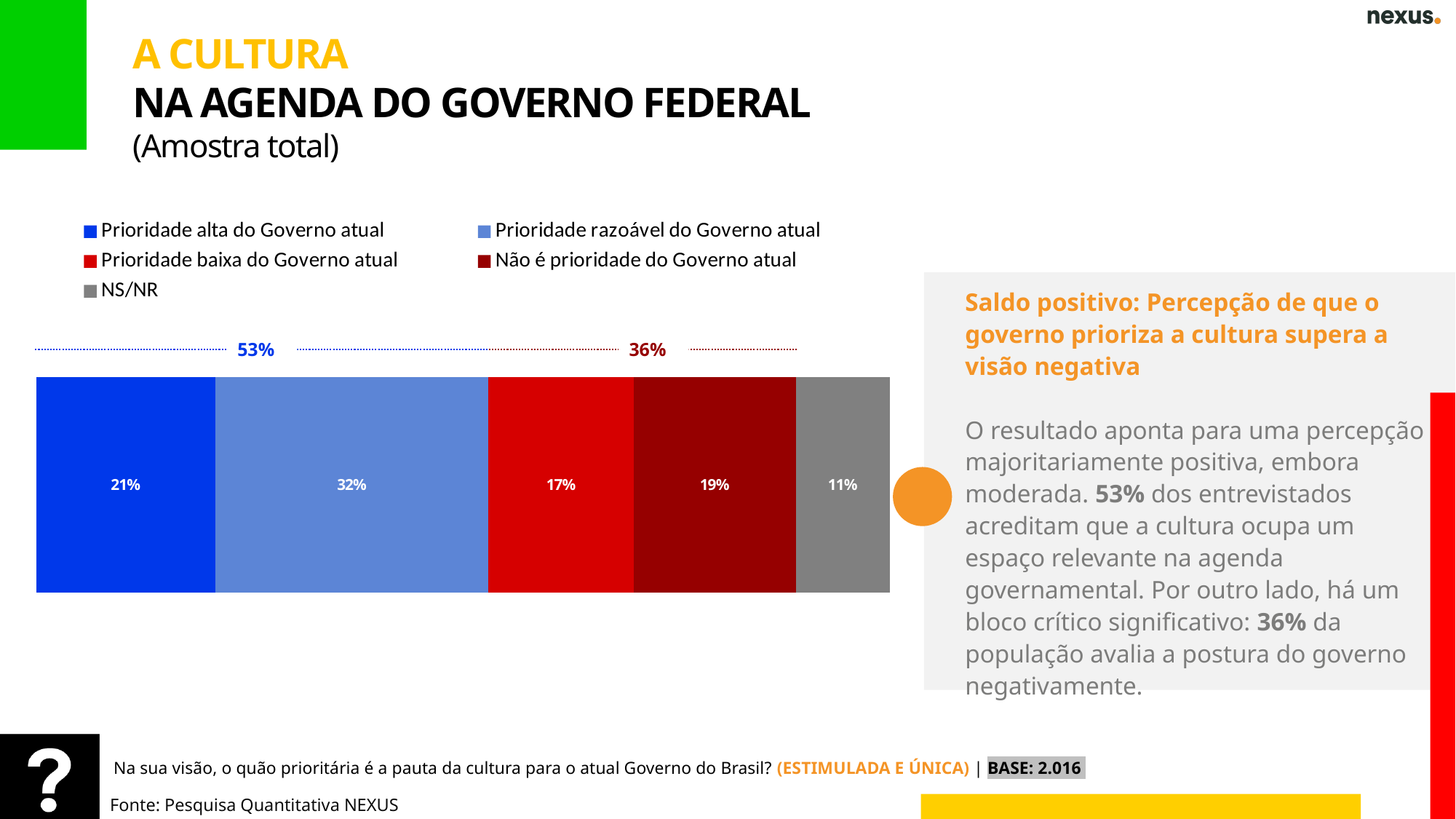
What is the value for 'Prioridade baixa do Governo atual'? 17% What is the value for NS/NR? 11% Which response category has the largest share in the bar? Prioridade razoável do Governo atual What is the value for 'Não é prioridade do Governo atual'? 19% What is the difference between 'Prioridade razoável do Governo atual' and 'Prioridade alta do Governo atual'? 11 percentage points Which is larger: 'Não é prioridade do Governo atual' or 'Prioridade baixa do Governo atual'? Não é prioridade do Governo atual What is the value for 'Prioridade razoável do Governo atual'? 32% Which response category has the smallest share in the bar? NS/NR How many series does the legend list? 5 What kind of chart is shown on the slide? Stacked bar chart What percentage of respondents said culture is a high priority of the current government (Prioridade alta do Governo atual)? 21% What combined percentage is shown above the bar for the two positive categories (alta and razoável)? 53%